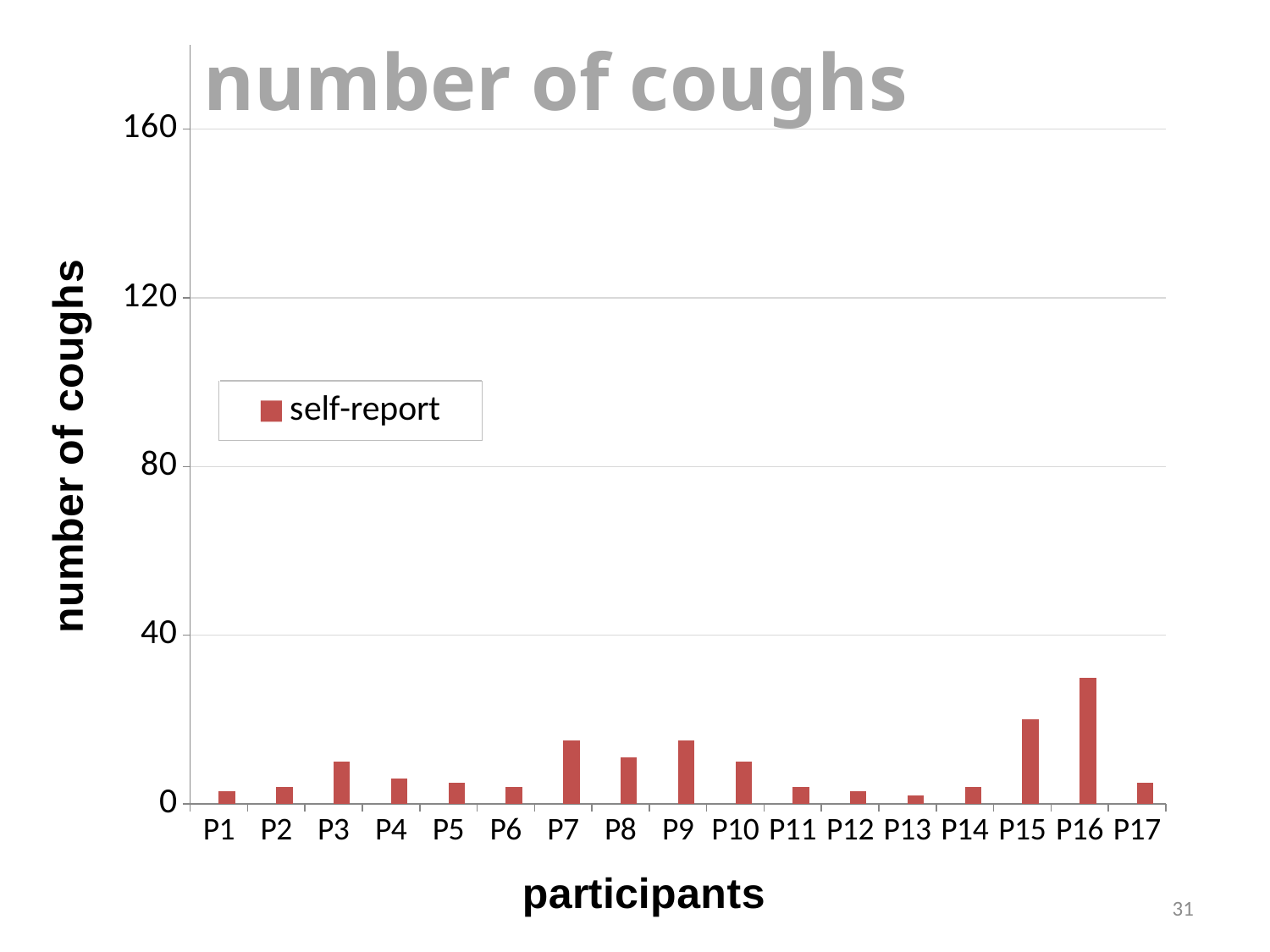
Is the value for P16 greater or less than 40? less Which participant has the highest number of self-reported coughs? P16 How many participants are shown on the x axis? 17 What is the title of the chart? number of coughs Which is larger, the value for P7 or the value for P1? P7 Is the value for P9 greater or less than 80? less Which is larger, the value for P3 or the value for P13? P3 Which is larger, the value for P16 or the value for P15? P16 How many series does the legend list? 1 What kind of chart is shown on the slide? bar chart What is the name of the series shown in the legend? self-report Is the value for P15 greater or less than 40? less